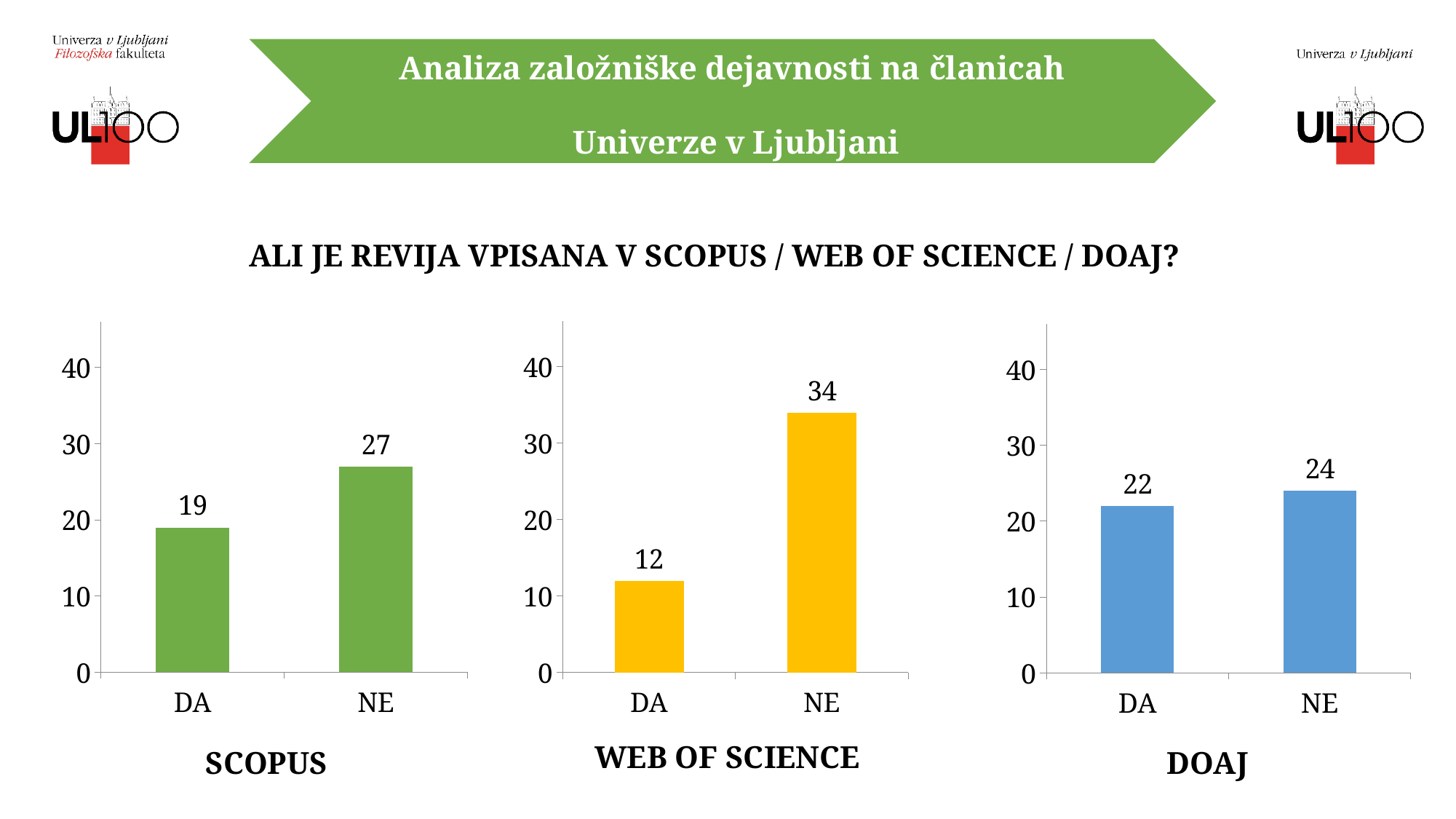
What colour are the bars in the DOAJ chart? Blue In the SCOPUS chart, what is the value for DA? 19 In the WEB OF SCIENCE chart, what is the value for NE? 34 In the WEB OF SCIENCE chart, what is the difference between NE and DA? 22 In the WEB OF SCIENCE chart, what is the value for DA? 12 In the DOAJ chart, what is the value for NE? 24 In the SCOPUS chart, which category has the higher value, DA or NE? NE In the SCOPUS chart, what is the value for NE? 27 In the DOAJ chart, what is the value for DA? 22 In the DOAJ chart, what is the difference between NE and DA? 2 How many categories does the DOAJ chart show? 2 What kind of chart is the WEB OF SCIENCE chart? Bar chart